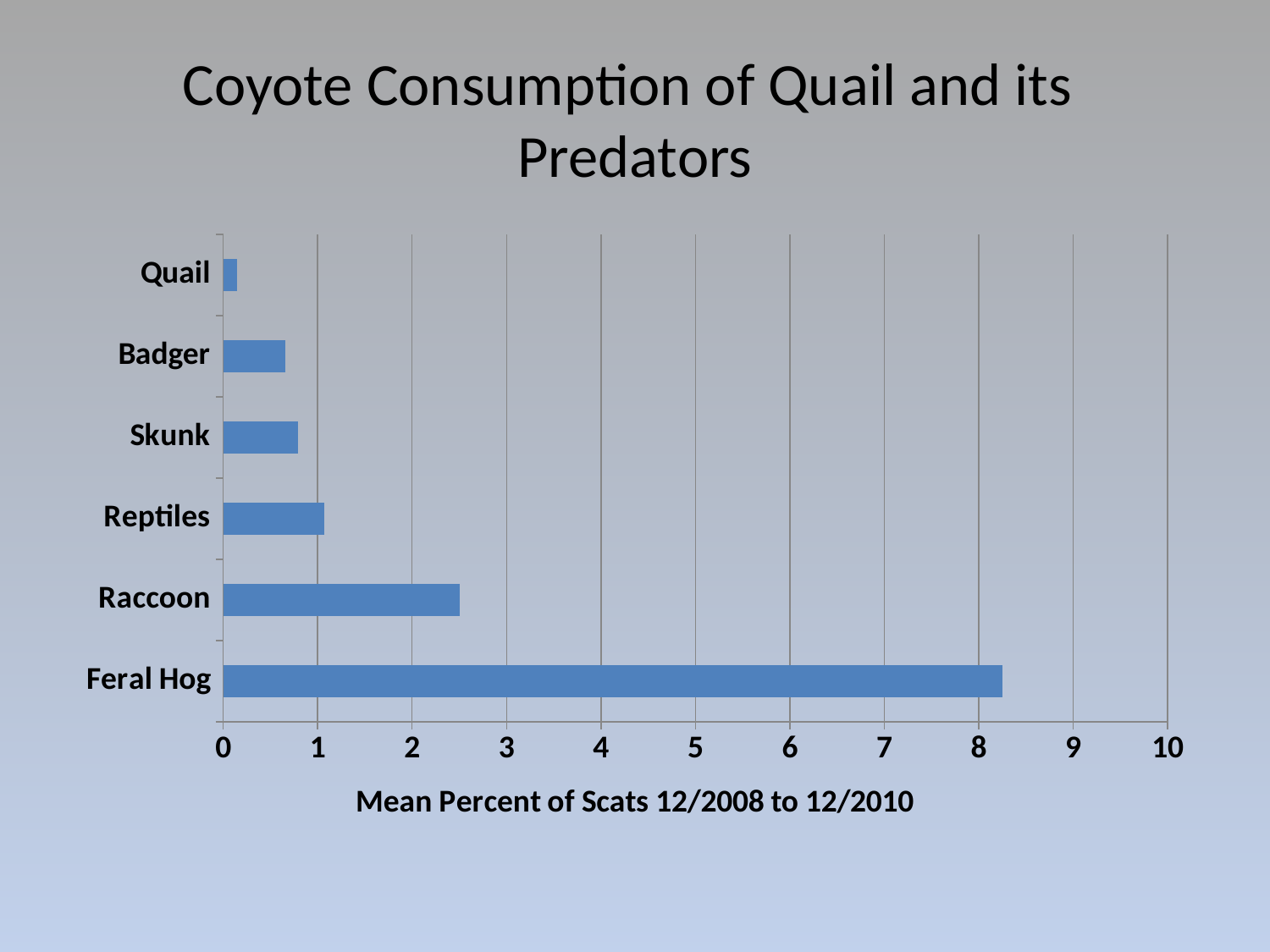
Is the value for Raccoon greater or less than 2? greater Which category has the lowest mean percent of scats? Quail How many categories are plotted on the chart? 6 Which is larger, the value for Raccoon or the value for Reptiles? Raccoon Is the value for Feral Hog greater or less than 8? greater Is the value for Raccoon greater or less than 3? less What kind of chart is shown on the slide? bar chart What is the label on the horizontal axis of the chart? Mean Percent of Scats 12/2008 to 12/2010 Which is larger, the value for Quail or the value for Skunk? Skunk Which category has the highest mean percent of scats? Feral Hog